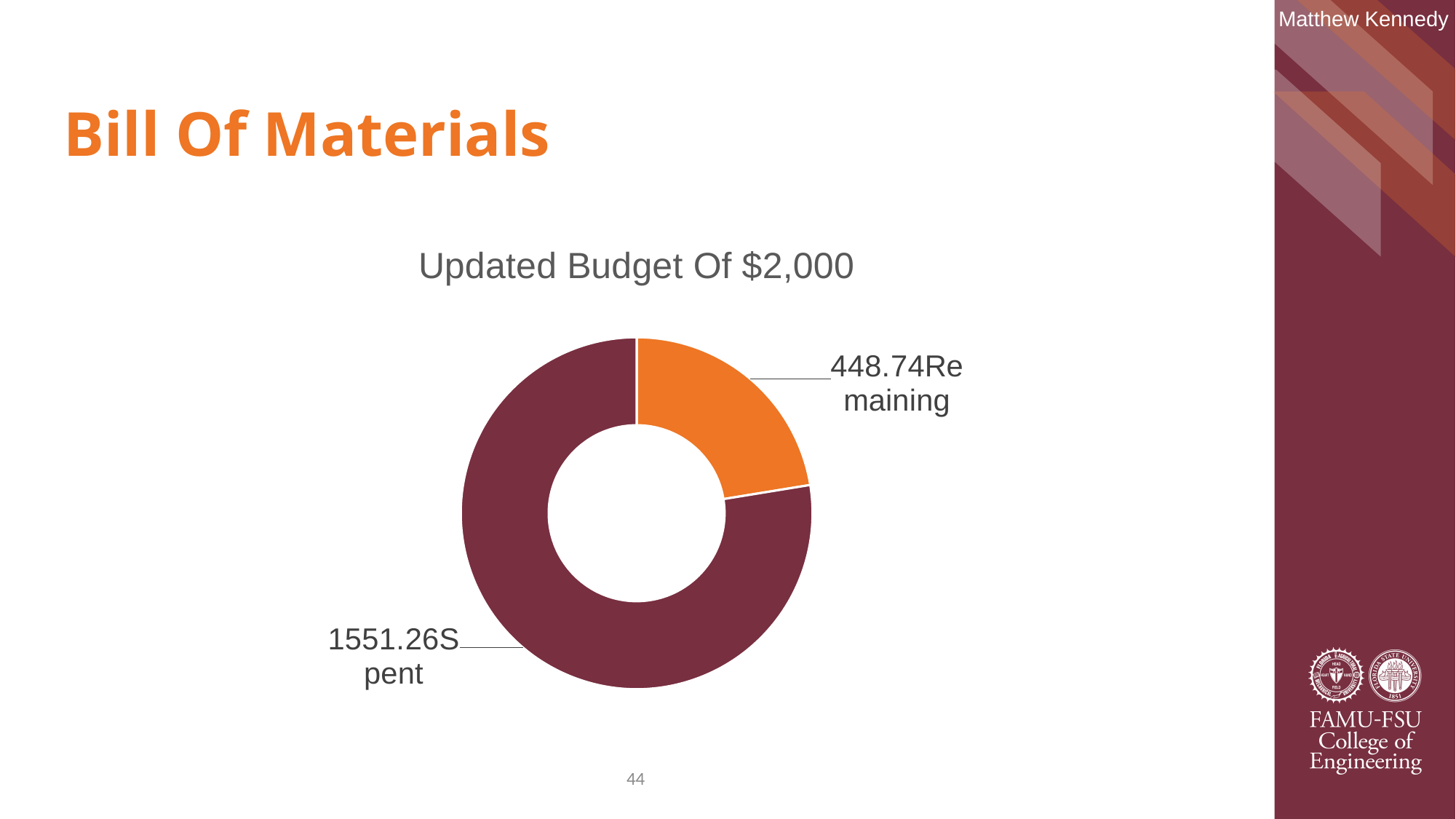
What kind of chart is shown on the slide? doughnut chart What is the title of the chart? Updated Budget Of $2,000 Which slice is the smallest? Remaining Which slice is the largest? Spent What is the total of the Spent and Remaining values? 2000 What colour is the Remaining slice? orange What is the value of the Remaining slice? 448.74 Which is larger, Spent or Remaining? Spent What is the value of the Spent slice? 1551.26 What is the difference between the Spent and Remaining values? 1102.52 How many slices does the chart have? 2